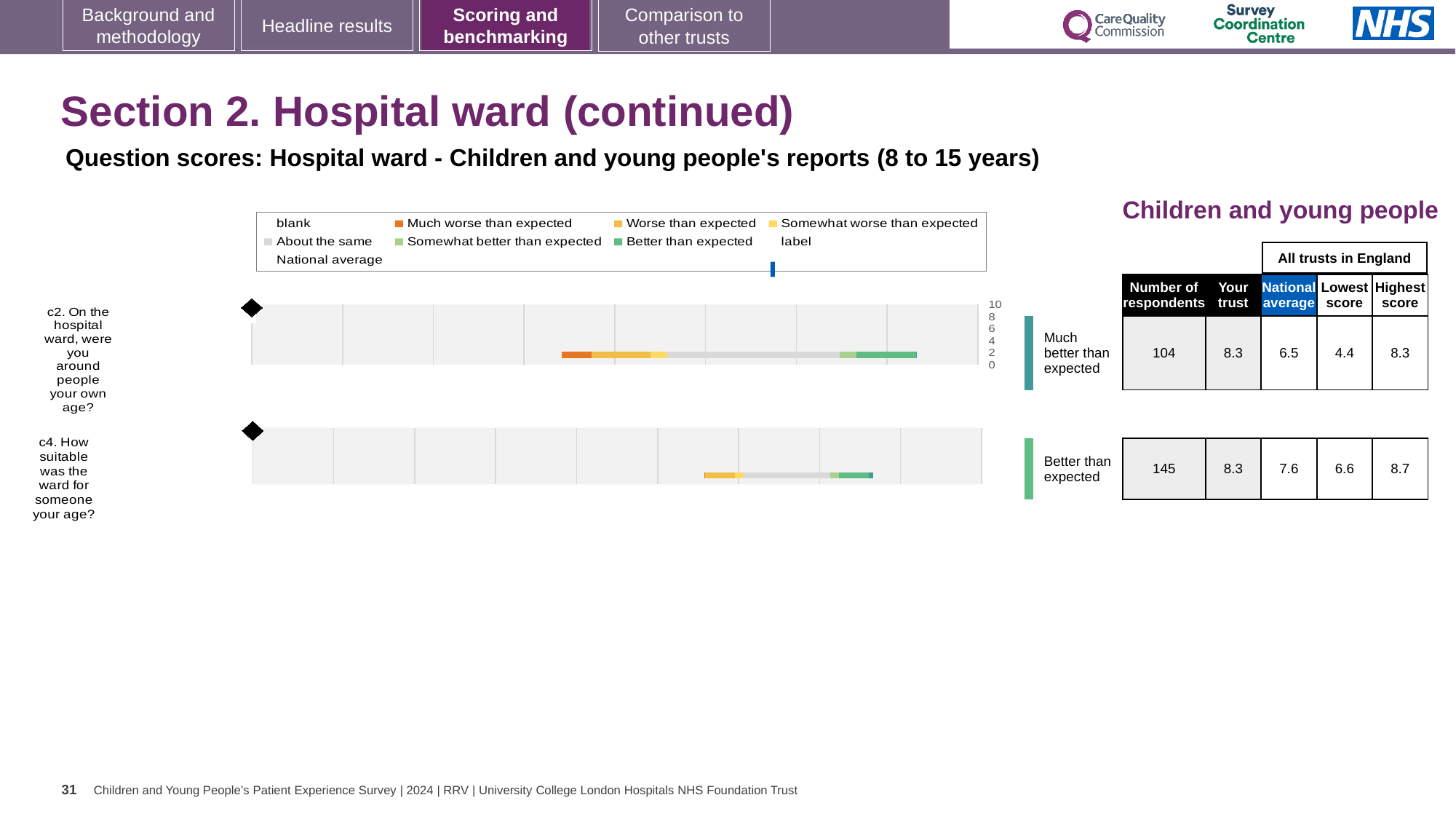
What is the 'Your trust' score for question c4 (How suitable was the ward for someone your age?)? 8.3 What is the highest score among all trusts in England for question c2? 8.3 What is the national average score for question c2? 6.5 What benchmark category is shown next to the bar for question c2? Much better than expected How many questions are plotted on the slide? 2 What is the lowest score among all trusts in England for question c4? 6.6 What is the maximum value shown on the score axis of the charts? 10 What is the difference between the highest and lowest scores for question c4? 2.1 What kind of chart is used to show the question scores for c2 and c4? Bar chart Which question has more respondents, c2 or c4? c4 What is the number of respondents for question c2 (On the hospital ward, were you around people your own age?)? 104 By how much does the trust's score for c2 exceed the national average for c2? 1.8